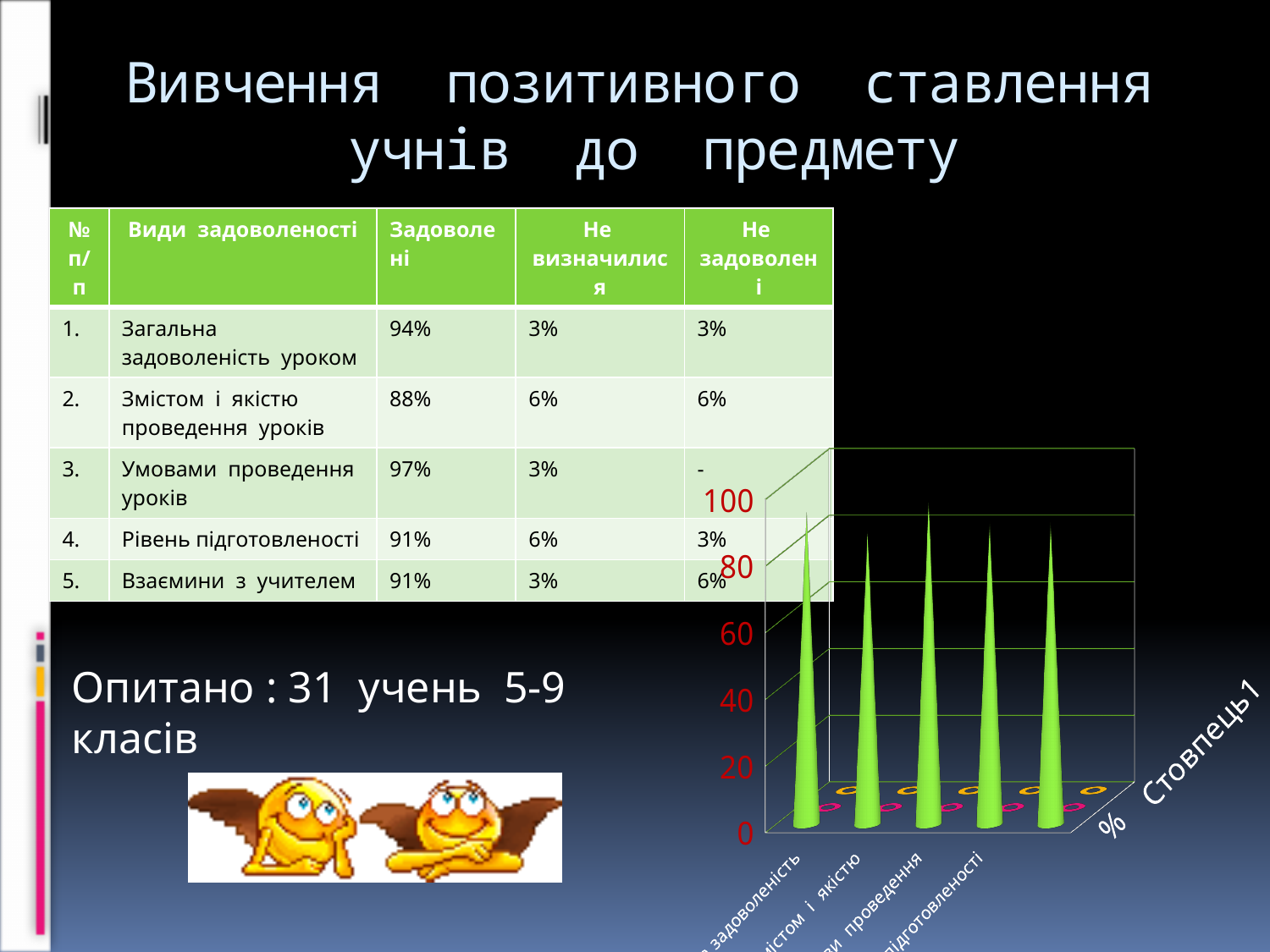
What kind of chart is shown on the slide? bar chart Is the value for "Умовами проведення" in the chart greater or less than 80? greater What is the label of the first series shown along the depth axis of the chart? % How many series labels are shown along the depth axis of the chart? 2 What is the highest tick value shown on the vertical axis of the chart? 100 Is the value for "Загальна задоволеність" in the chart greater or less than 80? greater Is the value for "Змістом і якістю" in the chart greater or less than 60? greater How many bars (cones) are plotted in the chart? 5